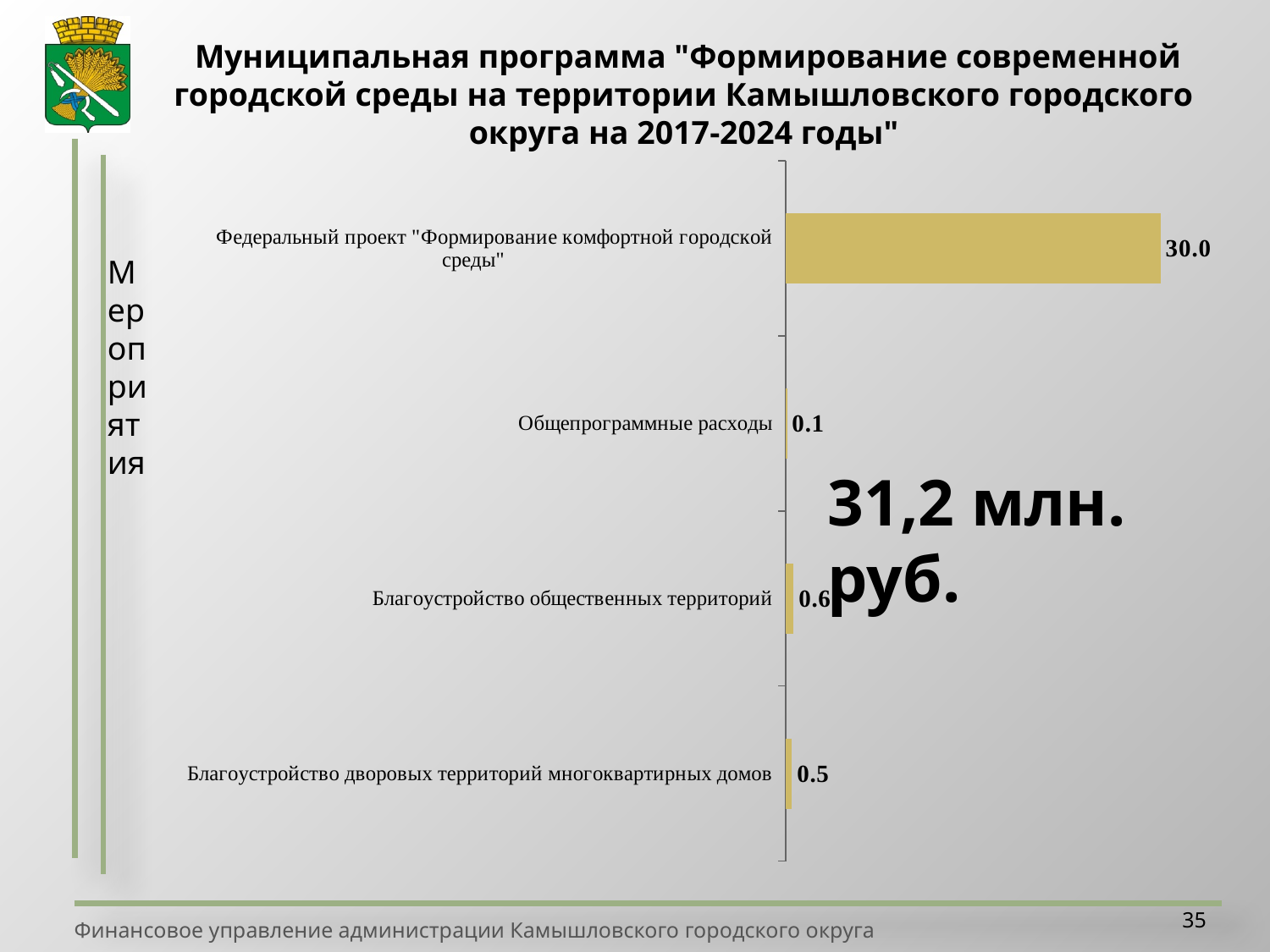
What is the value for "Благоустройство дворовых территорий многоквартирных домов"? 0.5 What kind of chart is shown on the slide? Bar chart Which category has the highest value? Федеральный проект "Формирование комфортной городской среды" How many categories are shown in the chart? 4 Which is larger: the value for "Благоустройство общественных территорий" or the value for "Общепрограммные расходы"? Благоустройство общественных территорий Which category has the lowest value? Общепрограммные расходы What is the difference between the values for "Благоустройство общественных территорий" and "Благоустройство дворовых территорий многоквартирных домов"? 0.1 What is the value for "Общепрограммные расходы"? 0.1 What is the value for "Федеральный проект "Формирование комфортной городской среды""? 30.0 What is the value for "Благоустройство общественных территорий"? 0.6 What total amount is printed in large text next to the chart? 31,2 млн. руб. What is the difference between the values for "Федеральный проект "Формирование комфортной городской среды"" and "Благоустройство общественных территорий"? 29.4